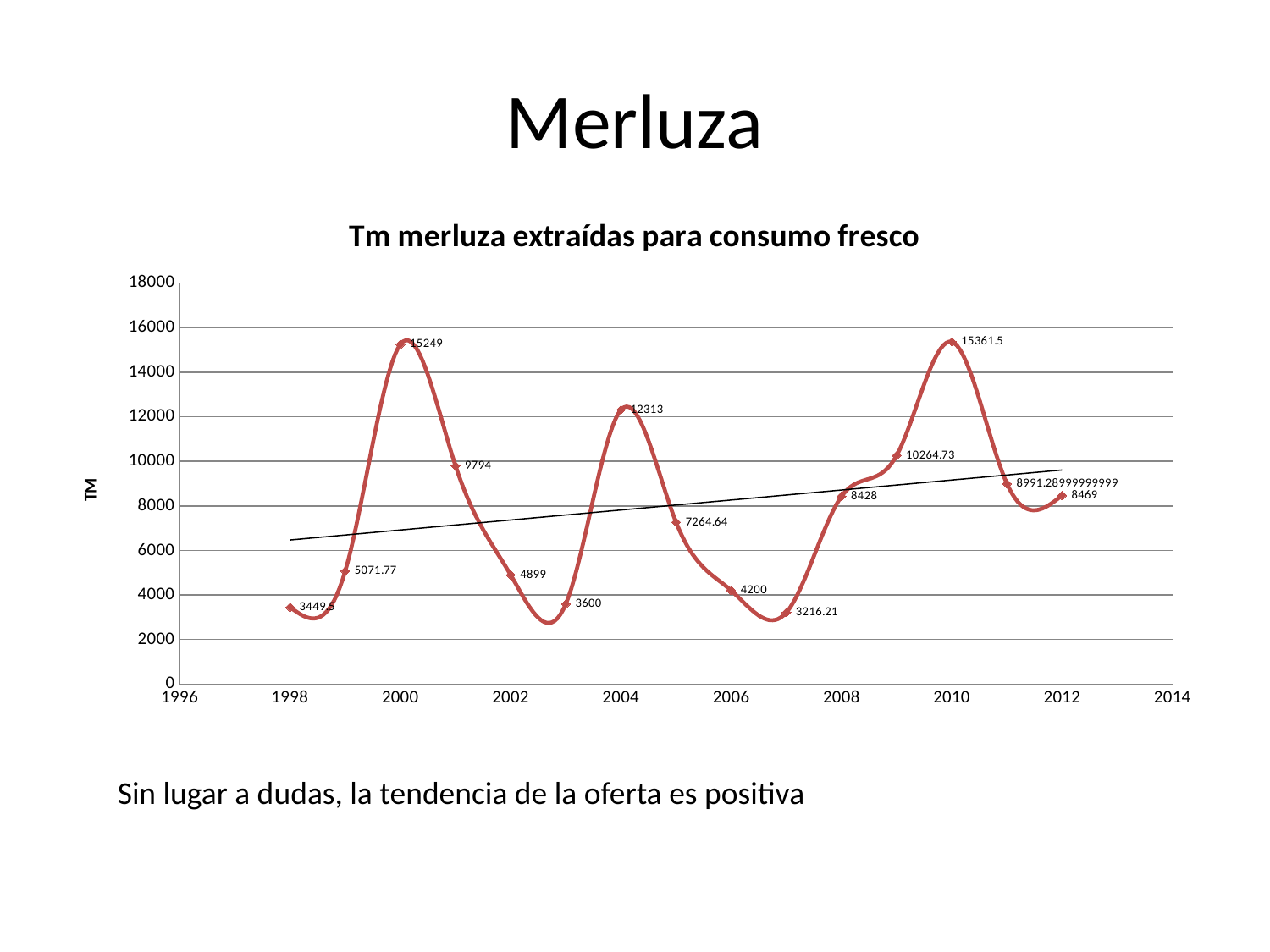
Which is larger, the value for 2008 or the value for 2012? 2012 What is the difference between the values for 2004 and 2003? 8713 What is the value for 2007? 3216.21 How many data points are plotted on the chart? 15 What kind of chart is shown on the slide? line chart Which year has the lowest value? 2007 What is the value for 2009? 10264.73 What is the value for 2000 in the chart "Tm merluza extraídas para consumo fresco"? 15249 What is the value for 2012? 8469 Which year has the highest value? 2010 What is the difference between the values for 2000 and 2001? 5455 Is the value for 2005 greater or less than 6000? greater